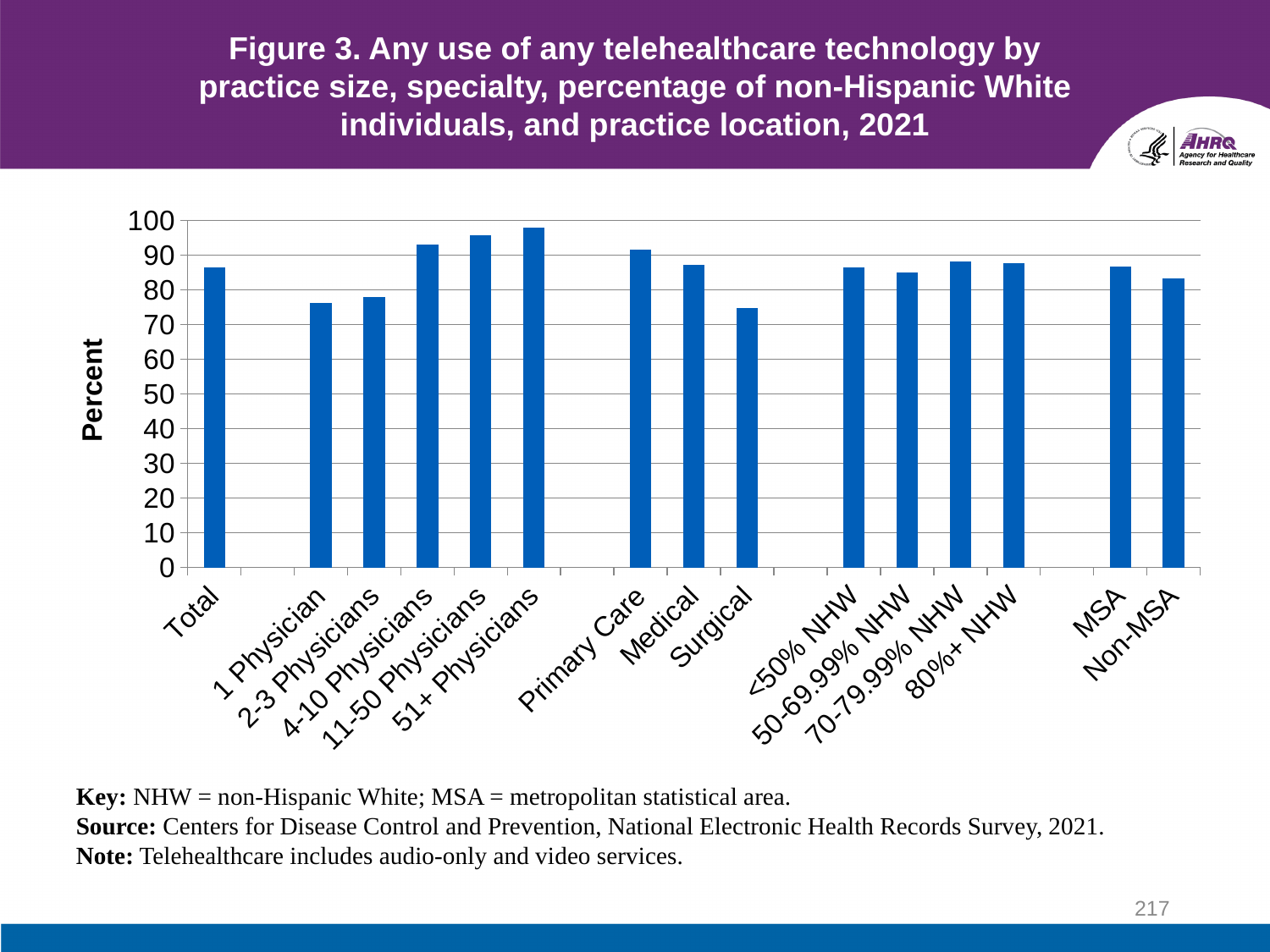
Is the value for 51+ Physicians greater or less than 90? greater Which is larger, the value for 2-3 Physicians or the value for 4-10 Physicians? 4-10 Physicians What kind of chart is shown on the slide? Bar chart Is the value for 1 Physician greater or less than 80? less Is the value for Non-MSA greater or less than 80? greater Which is larger, the value for Primary Care or the value for Surgical? Primary Care How many bars (categories) are plotted in the chart? 15 Across the practice size categories from 1 Physician to 51+ Physicians, do the values rise or fall? rise Which category has the highest value in the chart? 51+ Physicians What is the label on the vertical axis of the chart? Percent